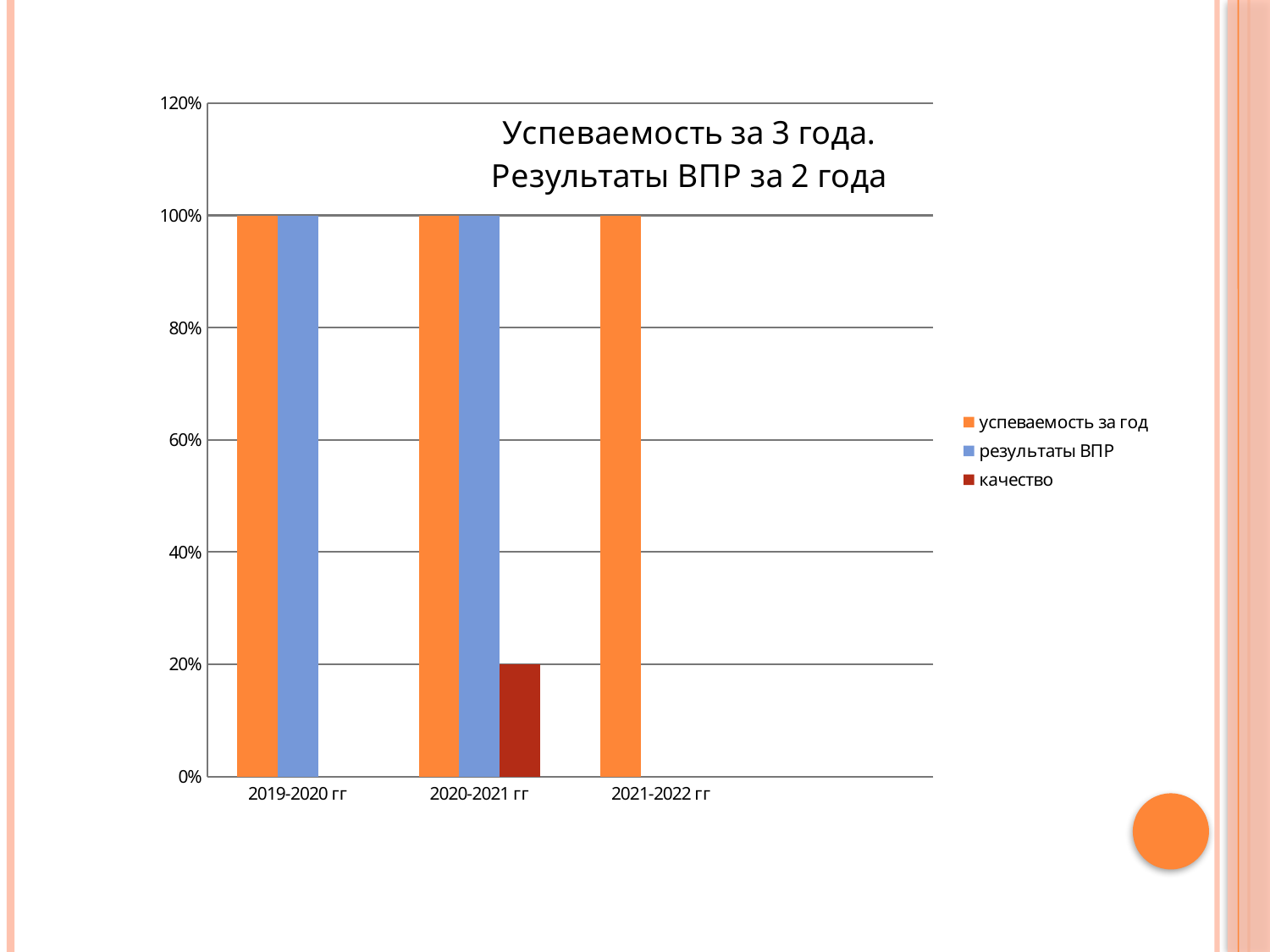
What kind of chart is shown on the slide? bar chart What is the value of успеваемость за год for 2019-2020 гг? 100% How many categories are shown on the x axis? 3 Is the value of качество for 2020-2021 гг greater or less than 40%? less What is the value of результаты ВПР for 2020-2021 гг? 100% What is the title of the chart? Успеваемость за 3 года. Результаты ВПР за 2 года How many series does the legend list? 3 What is the difference between результаты ВПР and качество for 2020-2021 гг? 80% Which is larger for 2020-2021 гг: успеваемость за год or качество? успеваемость за год What is the value of успеваемость за год for 2021-2022 гг? 100% What is the value of качество for 2020-2021 гг? 20% Which series has the lowest value for 2020-2021 гг? качество